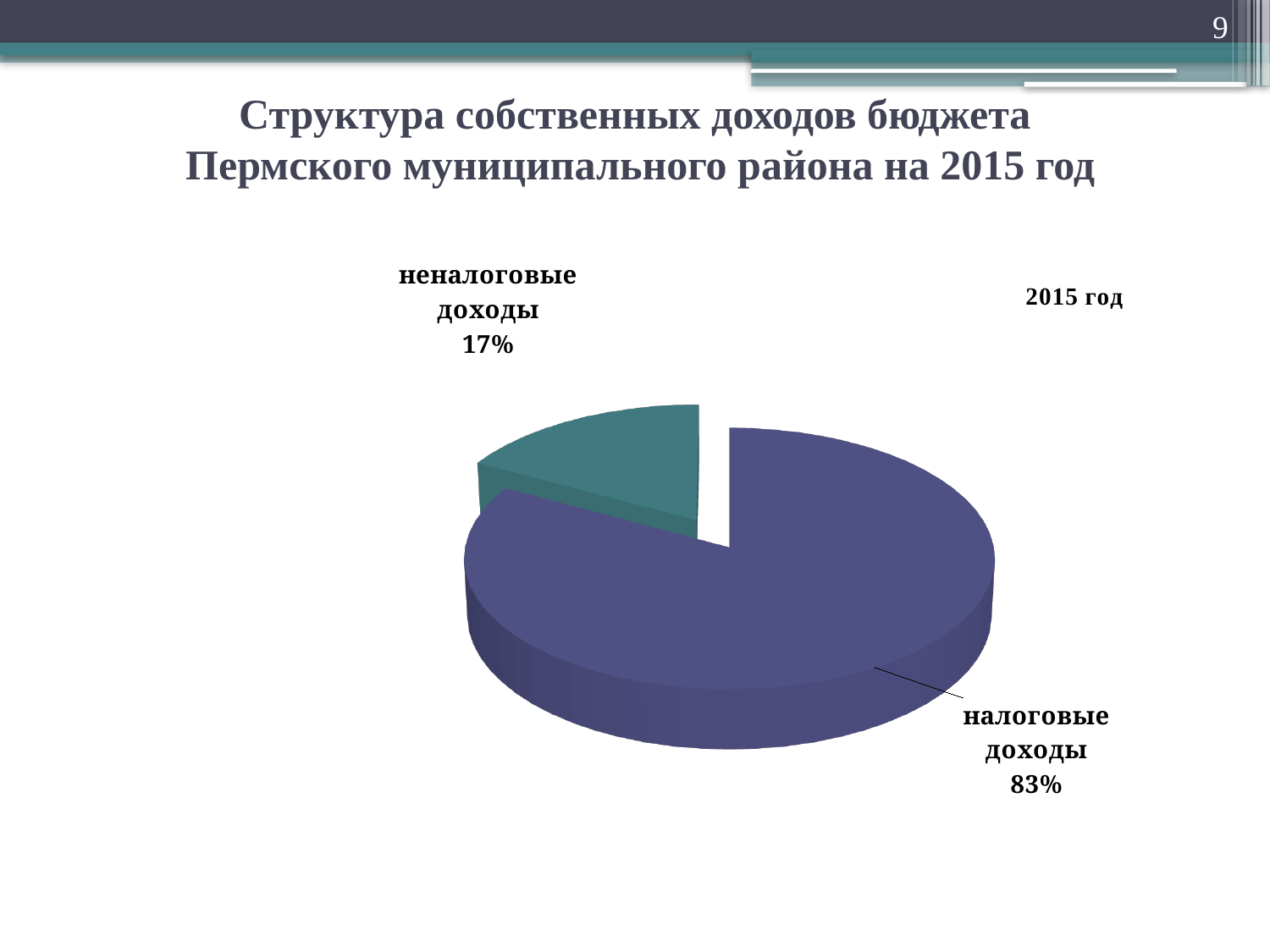
What is the difference in percentage points between "налоговые доходы" and "неналоговые доходы"? 66 What share of the pie does "налоговые доходы" represent? 83% What colour is the "неналоговые доходы" slice? teal (green) Which is larger: "налоговые доходы" or "неналоговые доходы"? налоговые доходы Which slice of the pie is the largest? налоговые доходы What is the title of the chart? 2015 год Which slice of the pie is the smallest? неналоговые доходы What share of the pie does "неналоговые доходы" represent? 17% What kind of chart is shown on the slide? pie chart How many slices does the pie chart have? 2